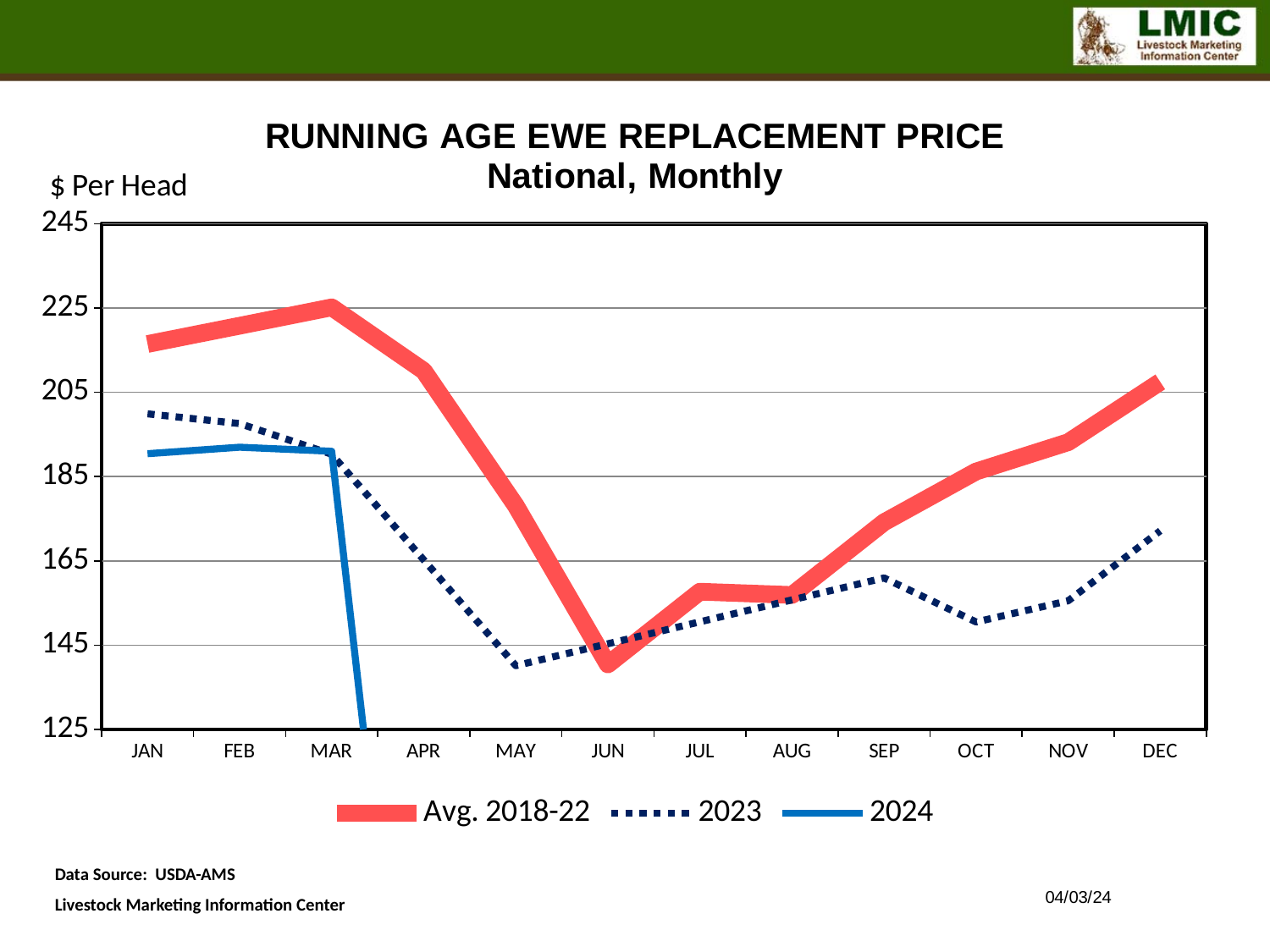
In which month is the 2023 series at its highest? JAN In which month does the Avg. 2018-22 series reach its highest value? MAR Is the 2023 value for MAY greater or less than 145? less Which series has the larger value in JAN, Avg. 2018-22 or 2023? Avg. 2018-22 How many months are shown along the x axis? 12 Does the Avg. 2018-22 series rise or fall from MAR to JUN? fall Is the 2024 value for JAN greater or less than 185? greater What kind of chart is shown on the slide? line chart What is the label on the y axis of the chart? $ Per Head Is the Avg. 2018-22 value for MAR greater or less than 205? greater In which month does the Avg. 2018-22 series reach its lowest value? JUN How many series does the legend list? 3